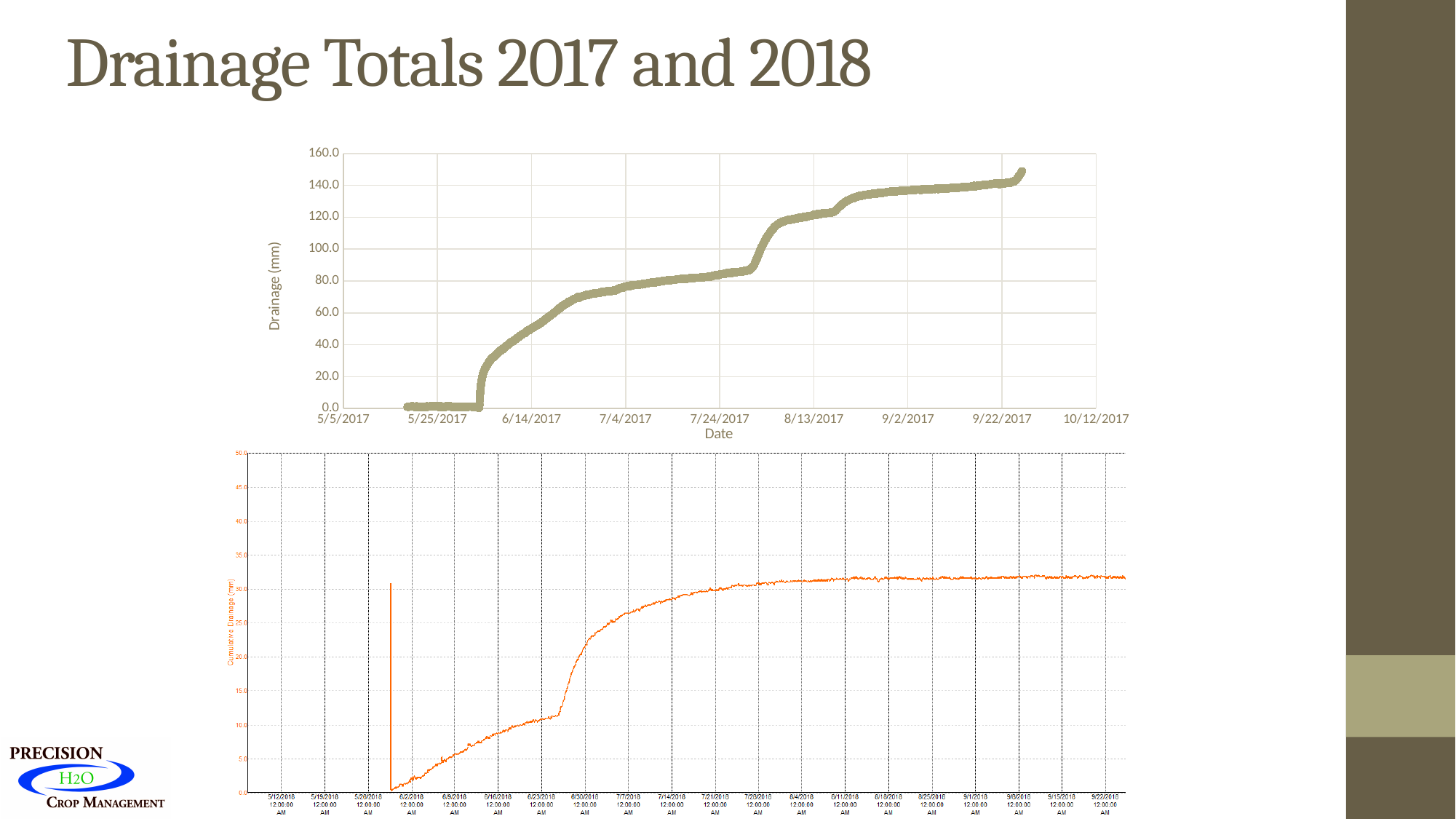
What kind of chart is the top chart on the slide? line chart In the bottom chart, does the cumulative drainage rise or fall along the x axis from 6/2/2018 to 9/22/2018? rise In the top chart, is the drainage value at the end of the series (late September 2017) greater or less than 140? greater In the top chart, is the drainage value at 5/25/2017 greater or less than 20? less What is the highest value shown on the y axis of the top chart? 160.0 In the top chart, do the drainage values rise or fall along the x axis from 5/25/2017 to 9/22/2017? rise In the bottom chart, is the cumulative drainage value at 9/22/2018 greater or less than 30? greater What is the y-axis title of the top chart? Drainage (mm) What kind of chart is the bottom chart on the slide? line chart